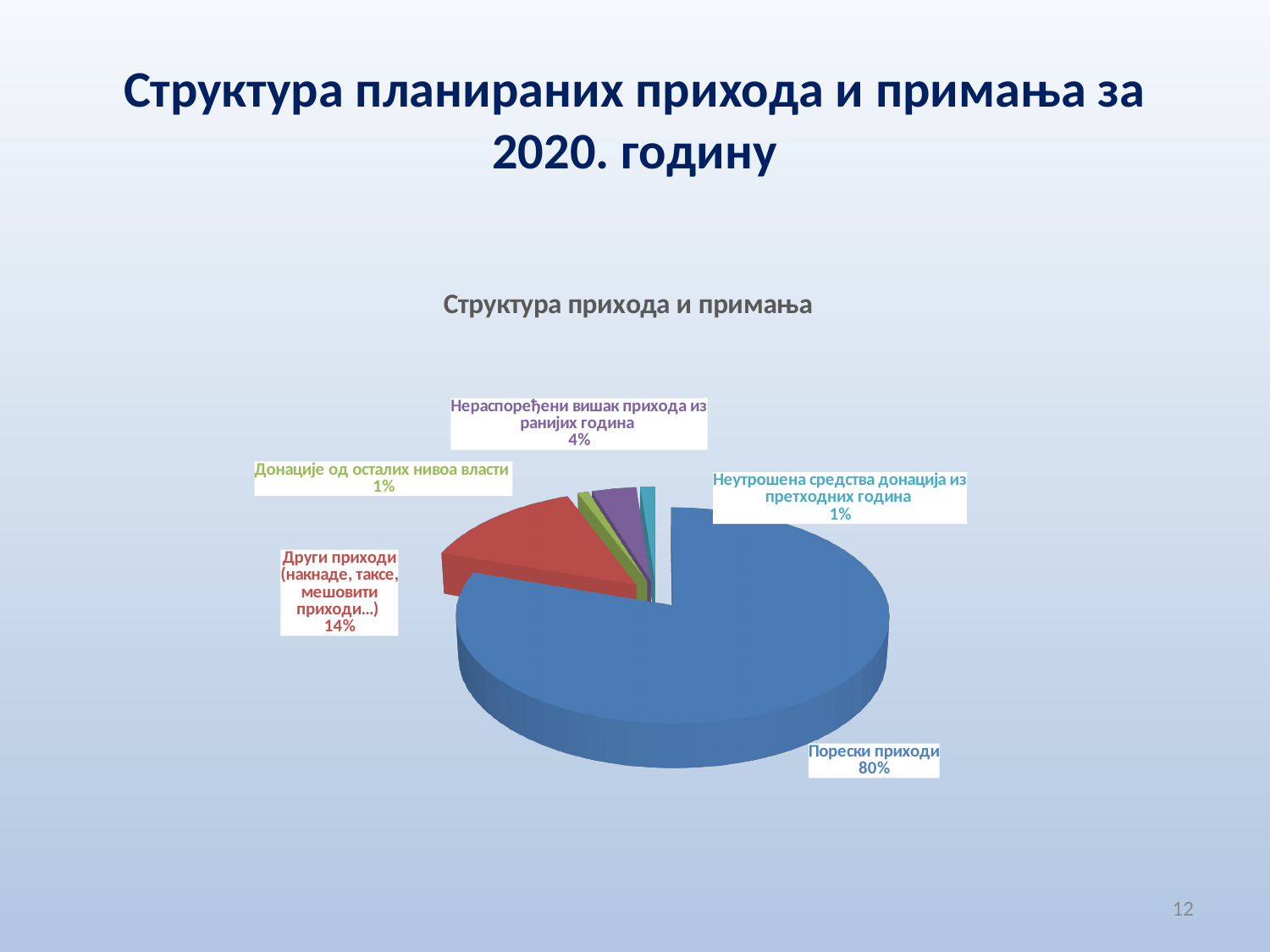
What share of the pie is Други приходи (накнаде, таксе, мешовити приходи...)? 14% What share of the pie is Порески приходи? 80% Which is larger: the share for Нераспоређени вишак прихода из ранијих година or the share for Донације од осталих нивоа власти? Нераспоређени вишак прихода из ранијих година How many slices does the pie chart have? 5 What type of chart is shown on the slide? Pie chart What share of the pie is Нераспоређени вишак прихода из ранијих година? 4% What is the title of the chart? Структура прихода и примања What is the difference in percentage points between Порески приходи and Други приходи (накнаде, таксе, мешовити приходи...)? 66 percentage points Which category has the largest share of the pie? Порески приходи What colour is the slice for Порески приходи? Blue